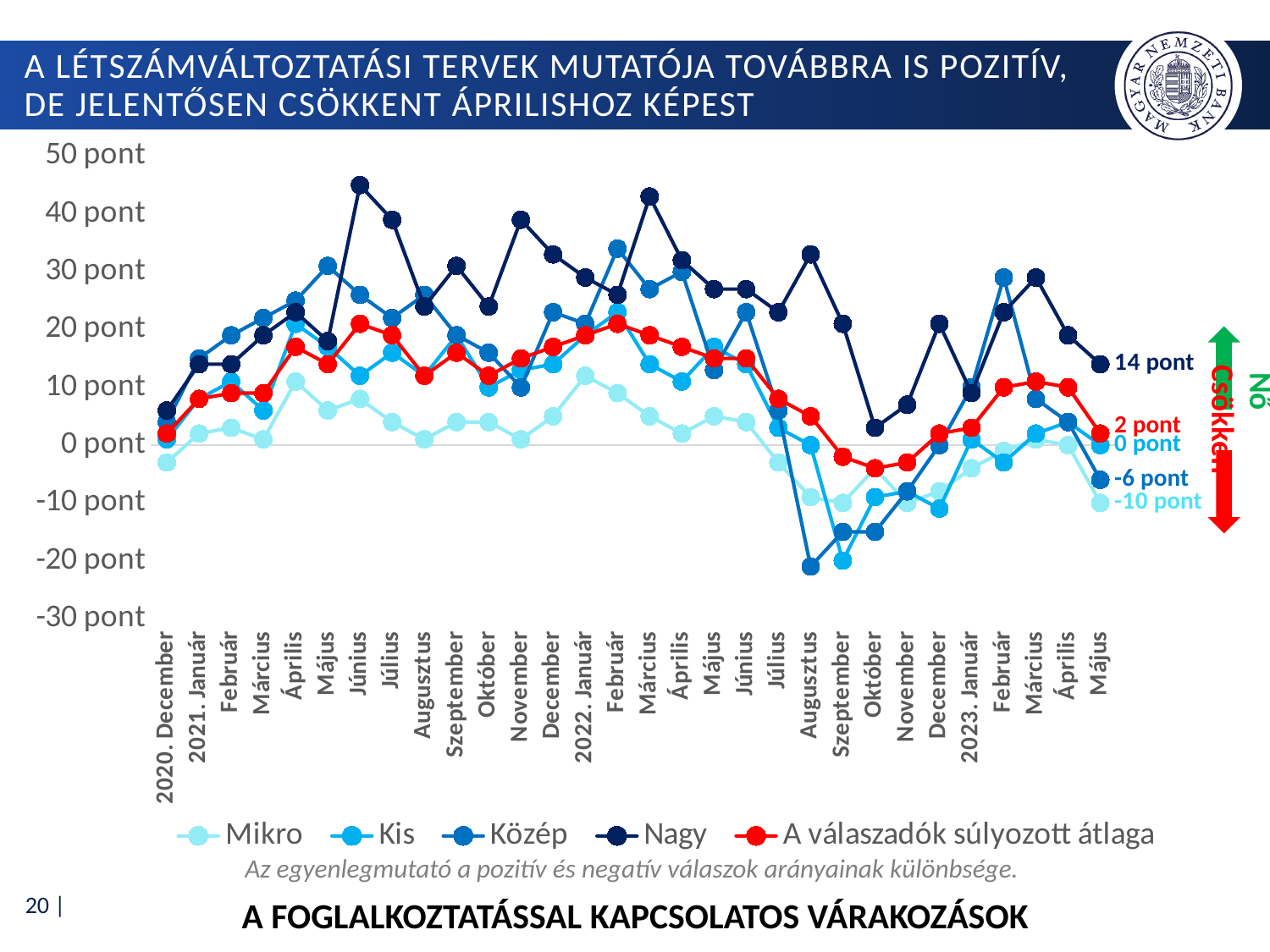
What kind of chart is shown on the slide? line chart Is the value for the Közép series in 2022 Augusztus greater or less than -10 pont? less What is the value for the Nagy series in 2023 Május? 14 pont What is the value for the Kis series in 2023 Május? 0 pont What is the difference between the Nagy and Mikro values in 2023 Május? 24 pont What is the value for the Mikro series in 2023 Május? -10 pont What is the value for 'A válaszadók súlyozott átlaga' in 2023 Május? 2 pont How many months are shown on the x axis? 30 How many series does the legend list? 5 Which series has the highest value in 2023 Május? Nagy What is the value for the Közép series in 2023 Május? -6 pont Is the value for the Nagy series in 2021 Június greater or less than 40 pont? greater